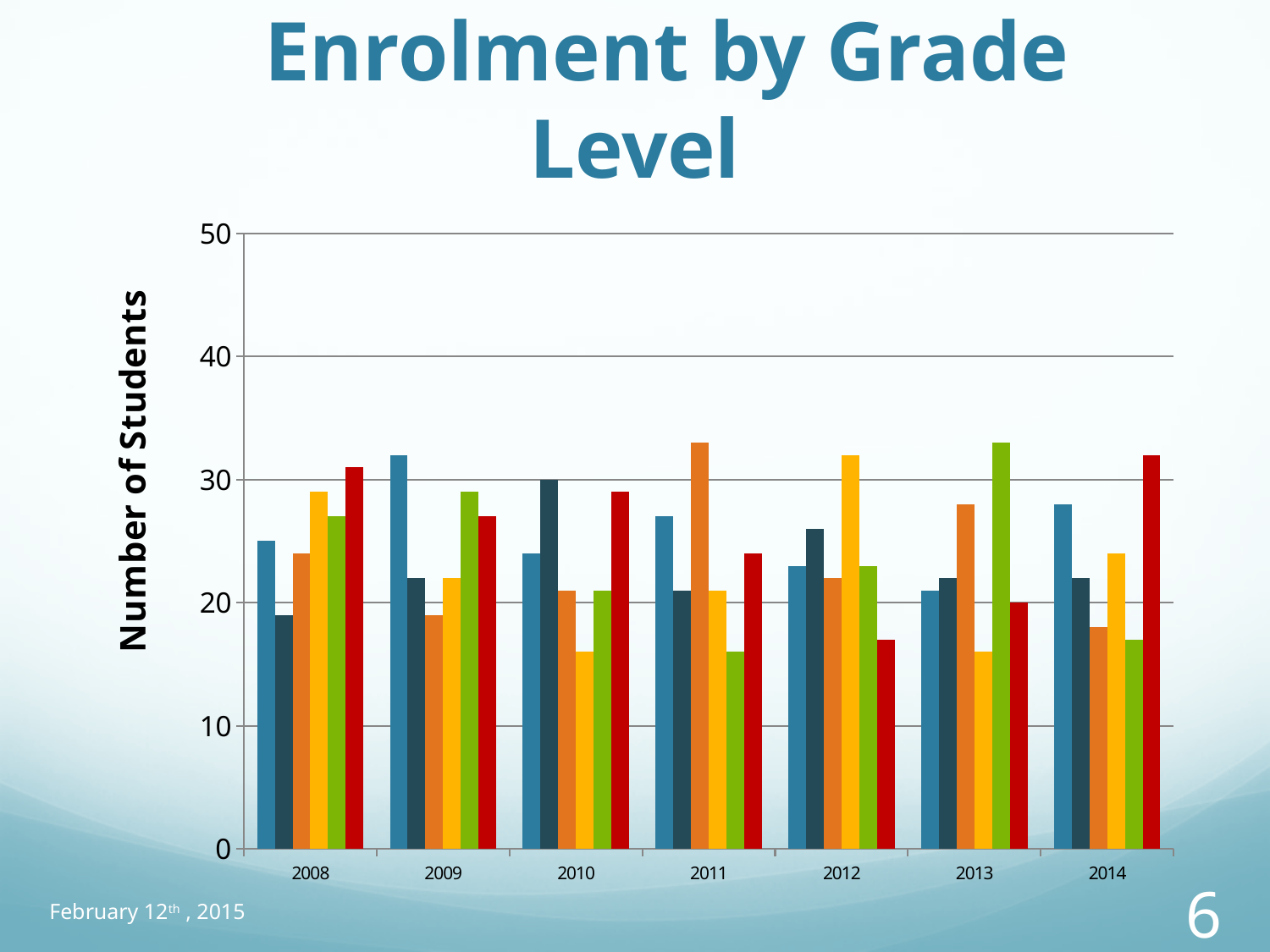
For 2009, which is larger: the light blue bar or the red bar? light blue What is the title of the chart on the slide? Enrolment by Grade Level Which coloured bar is the shortest for 2011? green Is the value of the yellow bar for 2010 greater or less than 20? less Is the value of the orange bar for 2011 greater or less than 30? greater What kind of chart is shown on the slide? bar chart Which coloured bar is the tallest for 2013? green How many bars are plotted for each year in the chart? 6 What is the label on the vertical axis of the chart? Number of Students How many years are shown along the x axis of the chart? 7 Is the value of the red bar for 2012 greater or less than 20? less